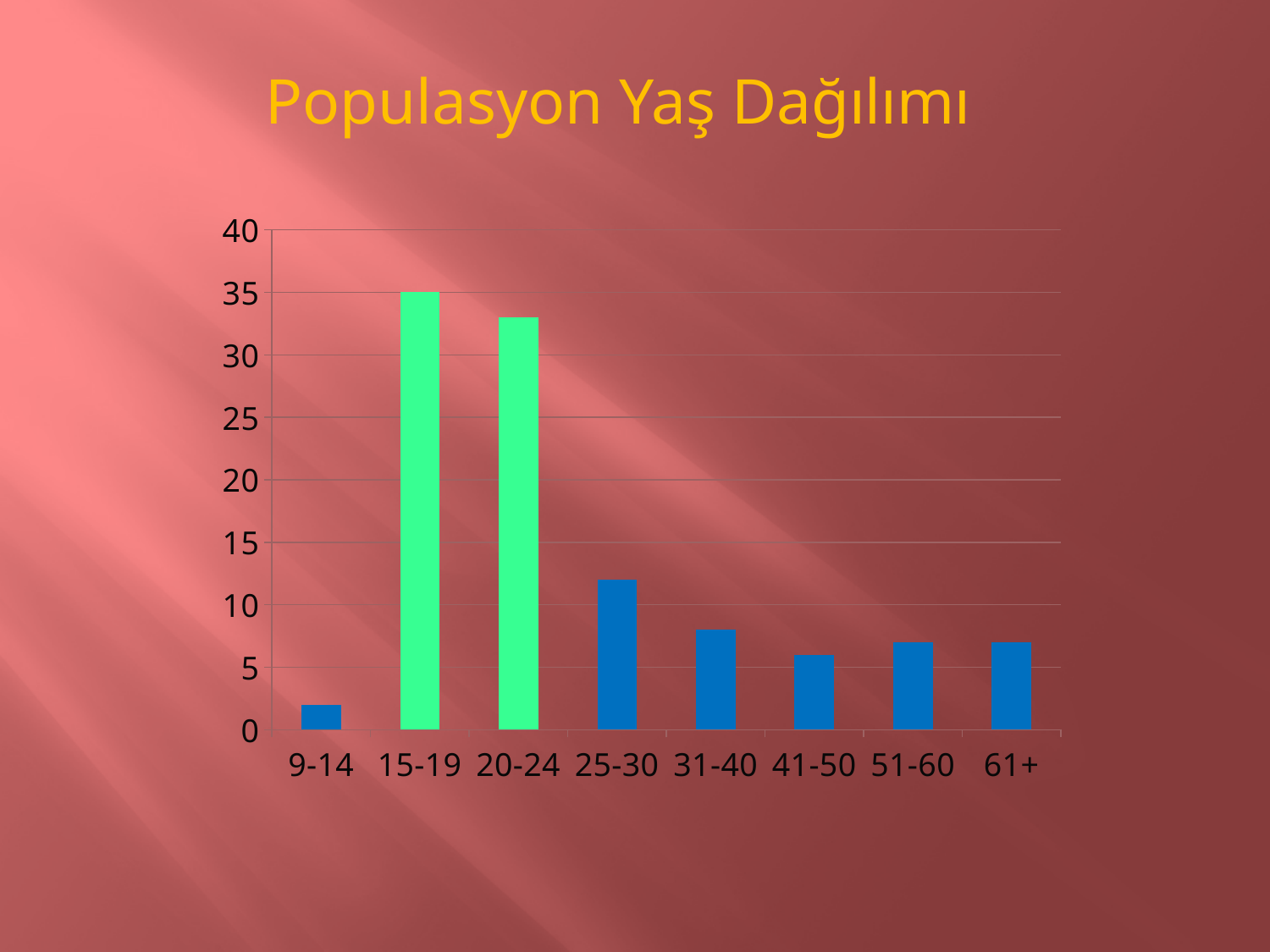
Which age groups are shown with green bars instead of blue? 15-19 and 20-24 Is the value for 9-14 greater or less than 5? less Which age group has the highest value? 15-19 Is the value for 25-30 greater or less than 10? greater What is the value for the 15-19 age group? 35 Is the value for 20-24 greater or less than 30? greater What type of chart is shown on the slide? bar chart Which is larger, the value for 25-30 or the value for 31-40? 25-30 Which age group has the lowest value? 9-14 What is the title of the chart? Populasyon Yaş Dağılımı How many age categories are shown on the x axis? 8